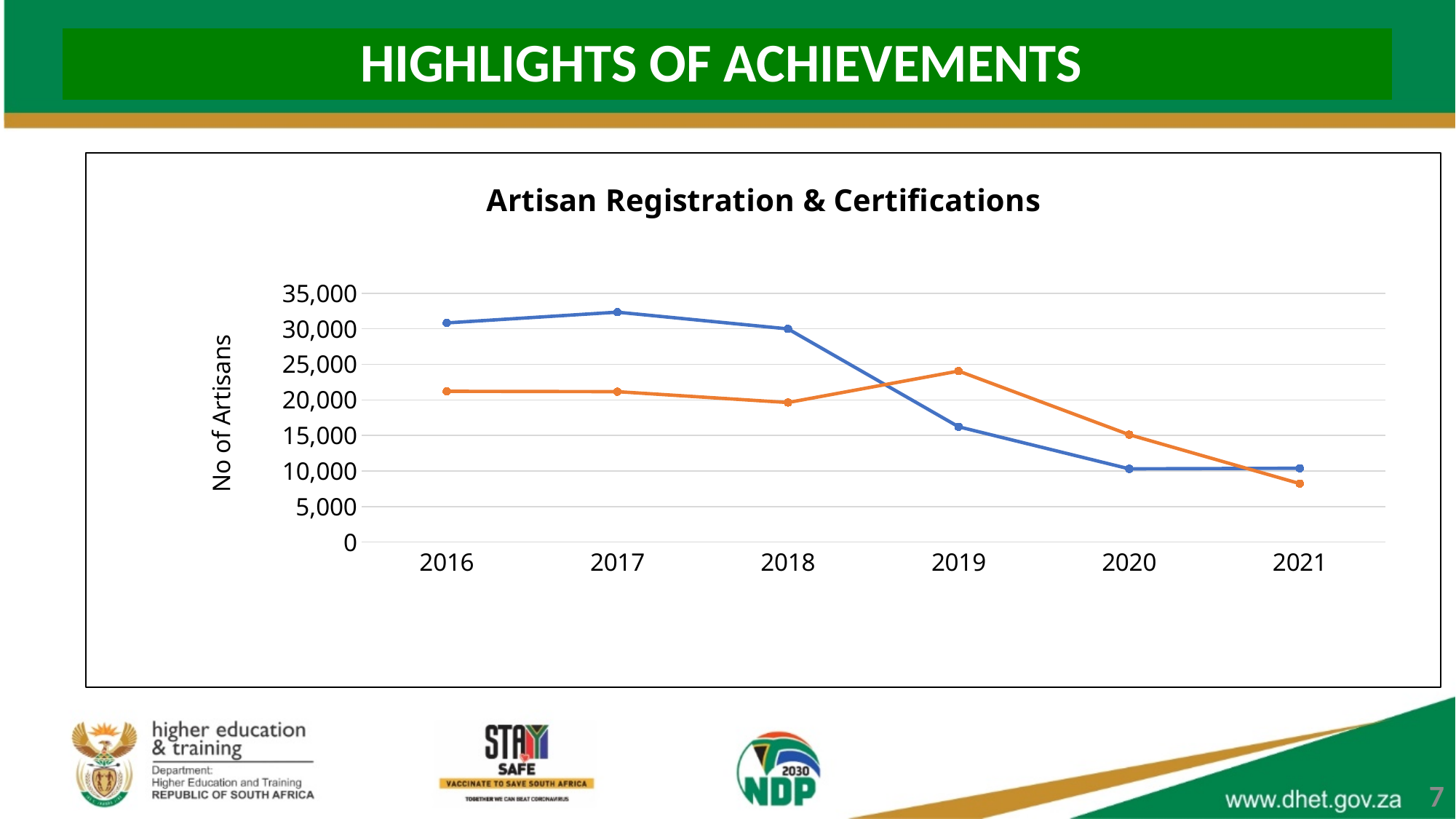
How many years are shown along the x axis of the chart? 6 Is the value of the blue line in 2019 greater or less than 20,000? less In which year does the blue line reach its highest value? 2017 How many lines are plotted on the chart? 2 What is the label on the vertical axis of the chart? No of Artisans What type of chart is shown on the slide? Line chart Is the value of the blue line in 2017 greater or less than 30,000? greater In 2019, which line has the higher value, the blue line or the orange line? The orange line What is the title of the chart? Artisan Registration & Certifications Is the value of the orange line in 2021 greater or less than 10,000? less In which year does the orange line reach its lowest value? 2021 In which year does the orange line reach its highest value? 2019